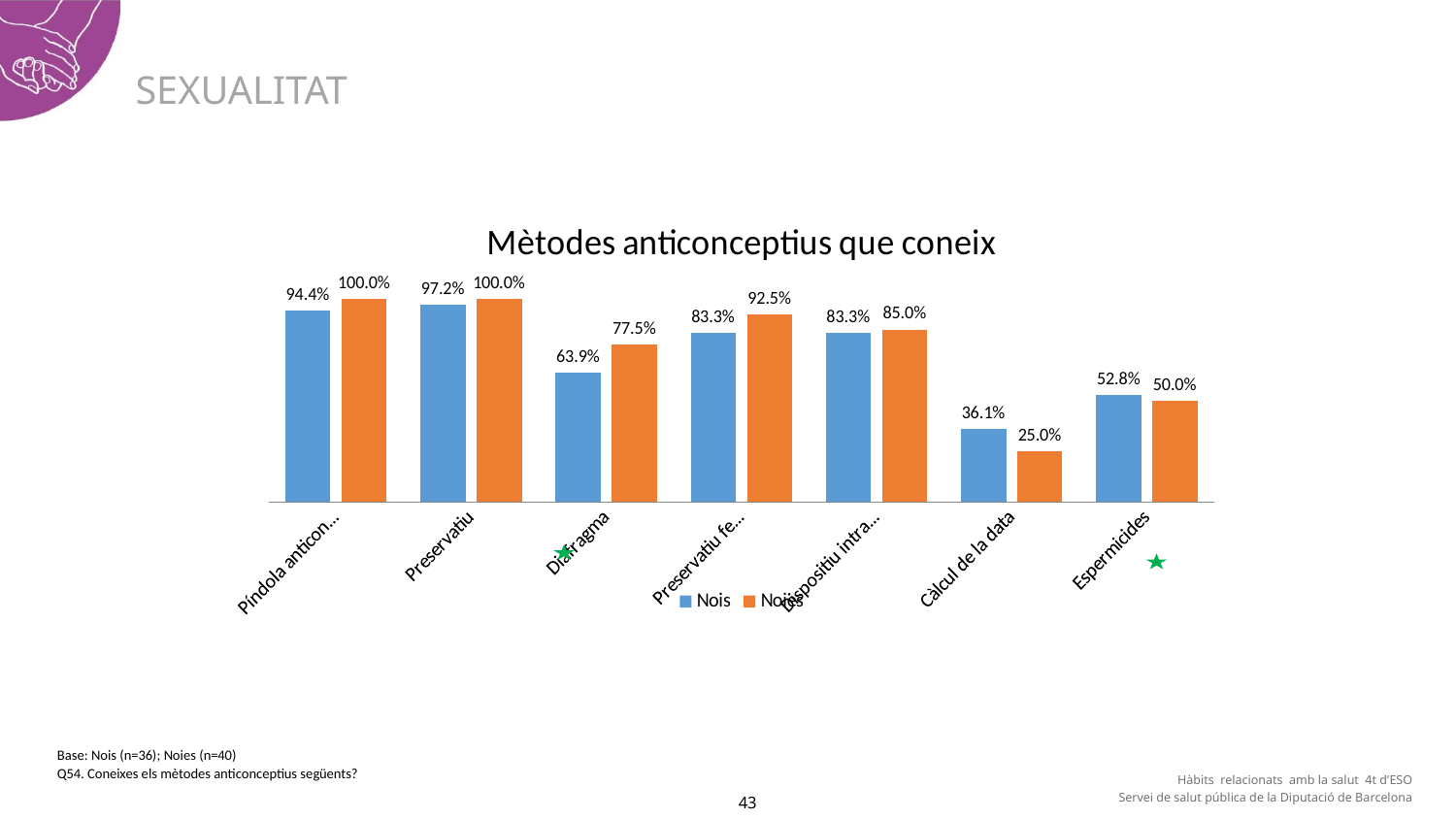
What is the difference between the Noies and Nois values for Diafragma? 13.6% What is the value for Noies for Espermicides? 50.0% What is the value for Nois for Càlcul de la data? 36.1% For Càlcul de la data, which is larger, the Nois value or the Noies value? Nois What is the value for Nois for Preservatiu? 97.2% What type of chart is shown on the slide? bar chart What is the value for Noies for Diafragma? 77.5% How many categories are shown on the x axis? 7 Which category has the highest value for Nois? Preservatiu Which category has the lowest value for Noies? Càlcul de la data How many series does the legend list? 2 What is the title of the chart? Mètodes anticonceptius que coneix